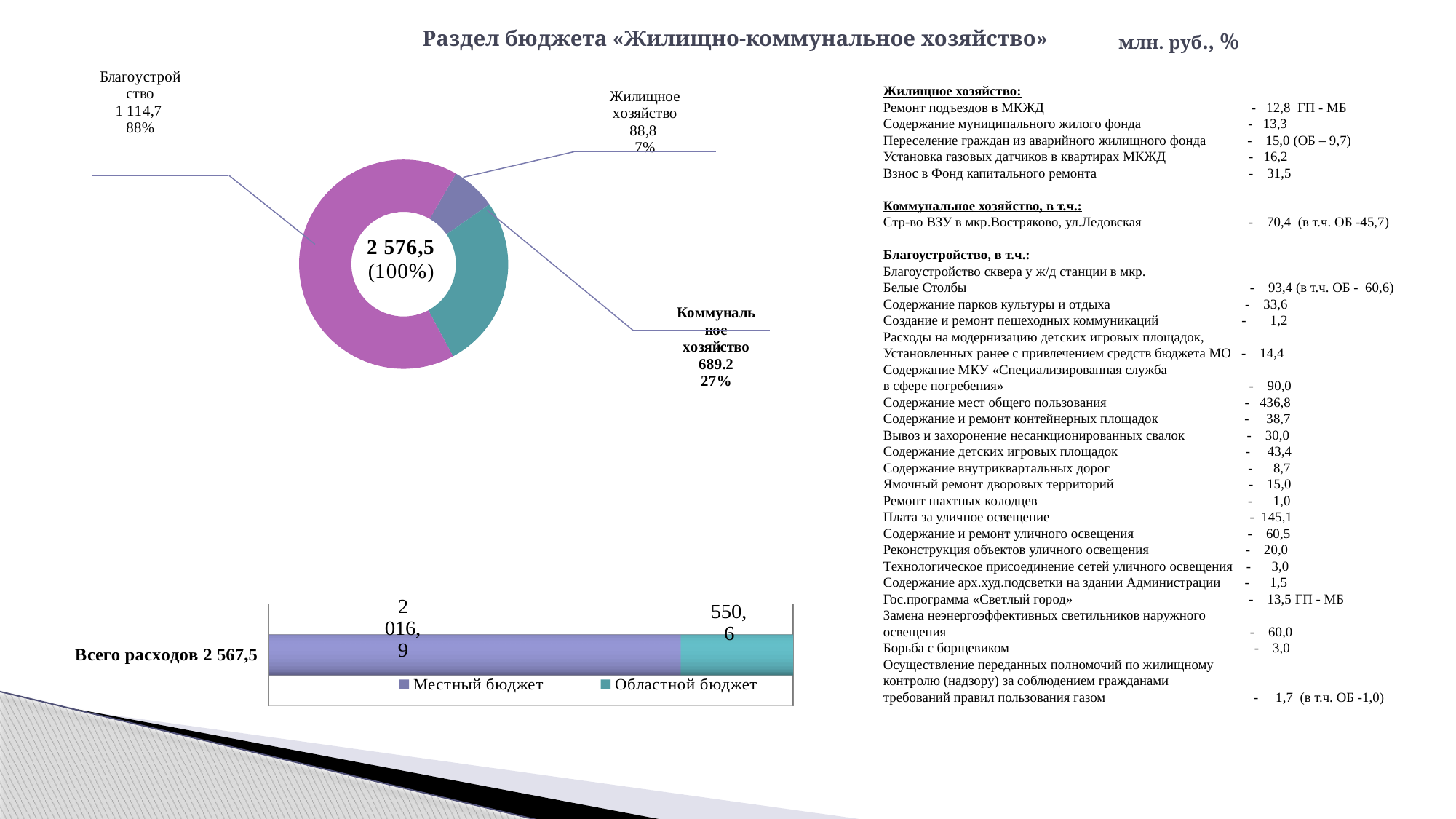
In the top-left pie chart, which category has the largest value? Благоустройство In the bottom-left bar chart, what is the value for Местный бюджет? 2 016,9 What kind of chart is the bottom-left chart labelled «Всего расходов 2 567,5»? bar chart How many slices does the top-left pie chart have? 3 In the top-left pie chart, what value is shown for Жилищное хозяйство? 88,8 What kind of chart is the top-left chart on the slide? pie chart (donut) In the bottom-left bar chart, what is the difference between Местный бюджет and Областной бюджет? 1 466,3 How many series does the legend of the bottom-left bar chart list? 2 In the top-left pie chart, what value is shown for Благоустройство? 1 114,7 In the top-left pie chart, what total value is printed in the centre of the donut? 2 576,5 In the top-left pie chart, what value is shown for Коммунальное хозяйство? 689.2 In the top-left pie chart, which category has the smallest value? Жилищное хозяйство